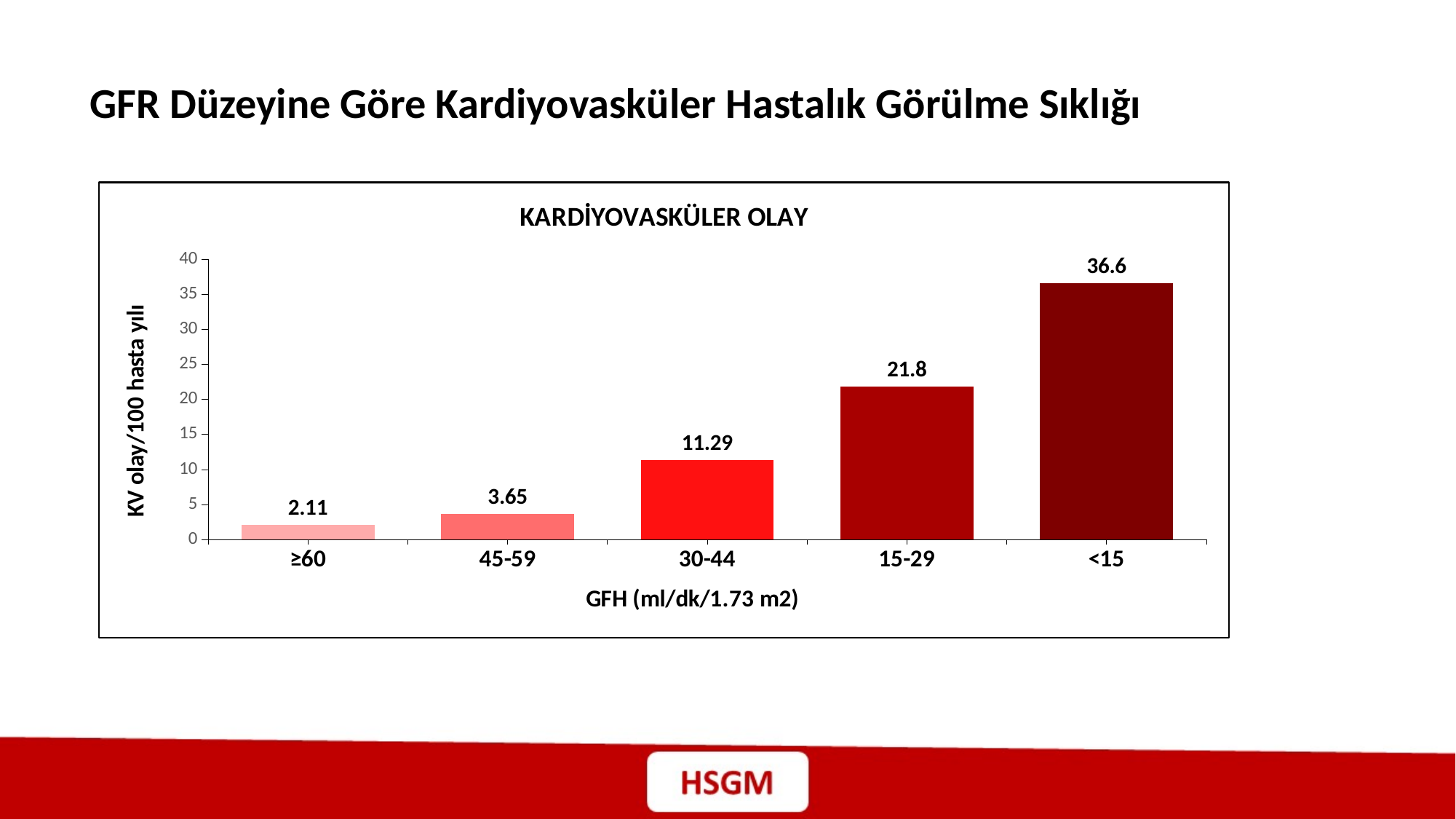
Do the values rise or fall moving from ≥60 to <15 along the x axis? Rise What is the value for the 30-44 GFH category? 11.29 Which has a larger value, 30-44 or 15-29? 15-29 Which GFH category has the lowest value? ≥60 What is the difference between the values for <15 and 15-29? 14.8 What is the value for the ≥60 GFH category? 2.11 How many GFH categories are shown on the x axis? 5 Which GFH category has the highest value? <15 What is the title of the chart? KARDİYOVASKÜLER OLAY What kind of chart is shown? Bar chart What is the value for the <15 GFH category? 36.6 What is the difference between the values for 45-59 and ≥60? 1.54